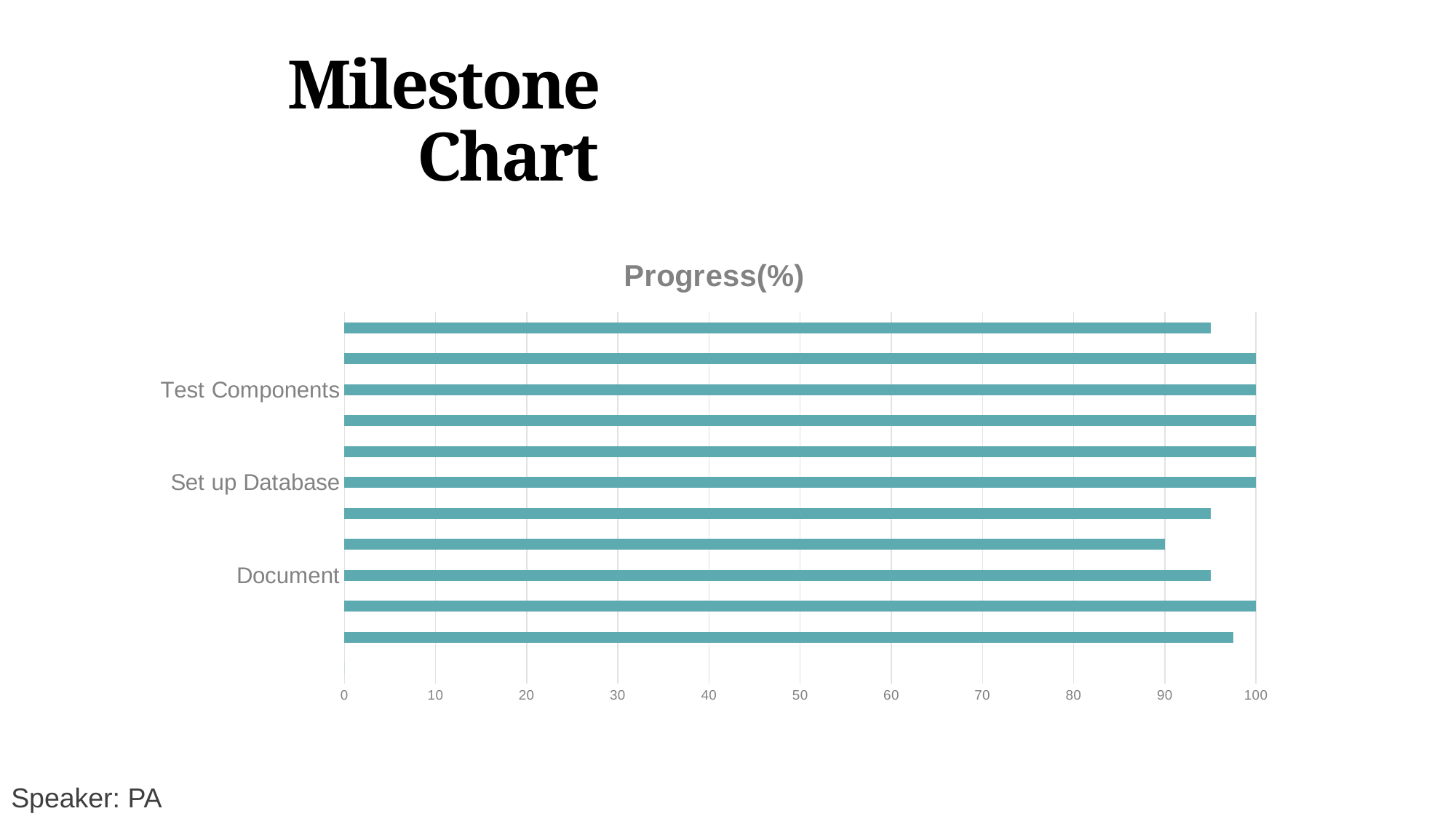
Which is larger, the value for Test Components or the value for Document? Test Components What is the value for Set up Database? 100 What is the title of the chart? Progress(%) What kind of chart is shown on the slide? bar chart How many bars are plotted in the chart? 11 Is the value for Document greater or less than 90? greater What is the highest value labelled on the horizontal axis? 100 Is the value for Document greater or less than 100? less What is the value for Test Components? 100 Which is larger, the value for Set up Database or the value for Document? Set up Database